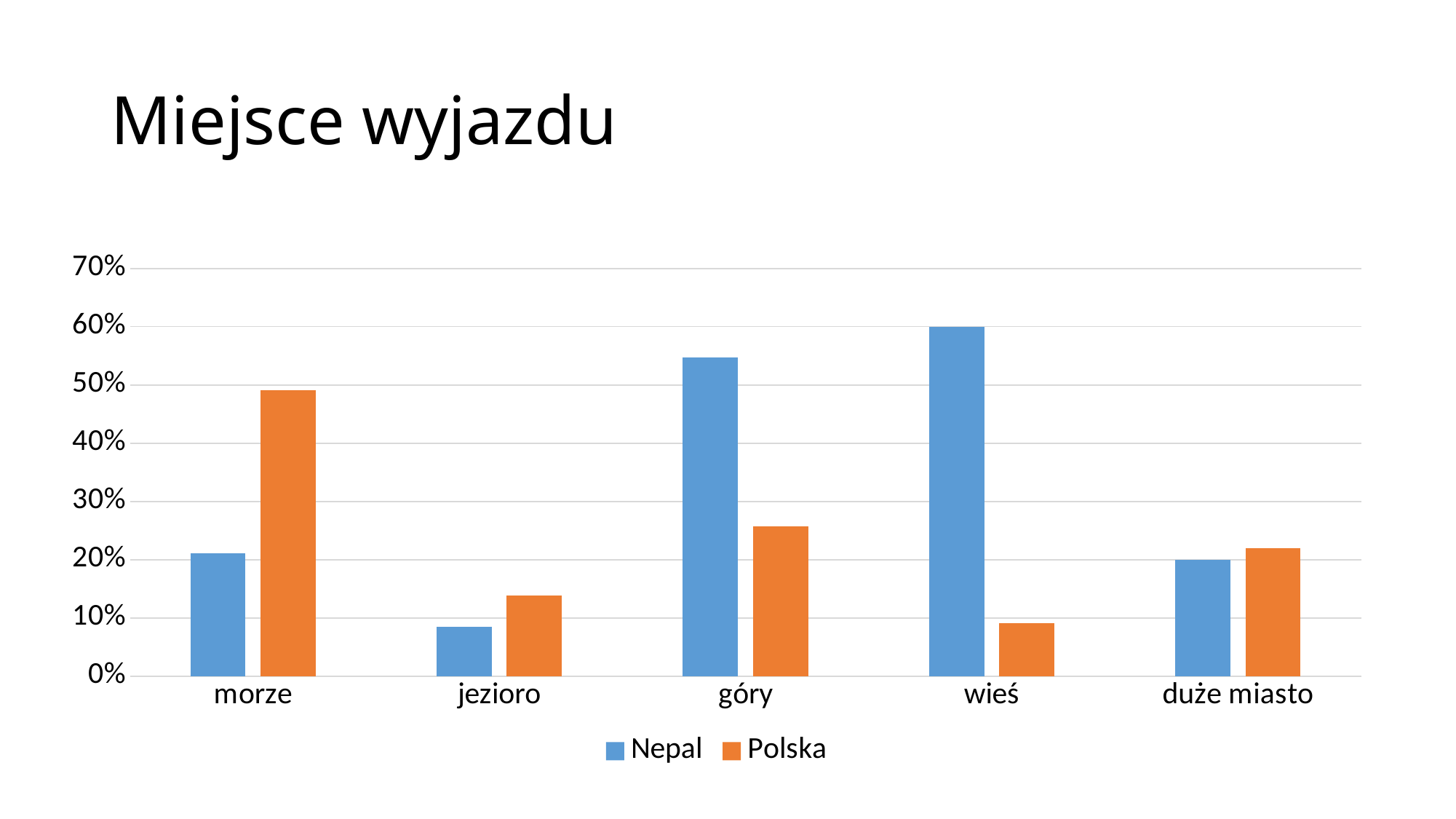
What is the title of the slide? Miejsce wyjazdu How many series does the legend list? 2 Which category has the lowest value for Nepal? jezioro For morze, which series has the larger value, Nepal or Polska? Polska Which category has the highest value for Polska? morze How many categories are shown on the x axis? 5 Which category has the highest value for Nepal? wieś Is the value for Nepal in jezioro greater or less than 10%? less For góry, which series has the larger value, Nepal or Polska? Nepal Which category has the lowest value for Polska? wieś What kind of chart is shown on the slide? bar chart Is the value for Polska in morze greater or less than 40%? greater